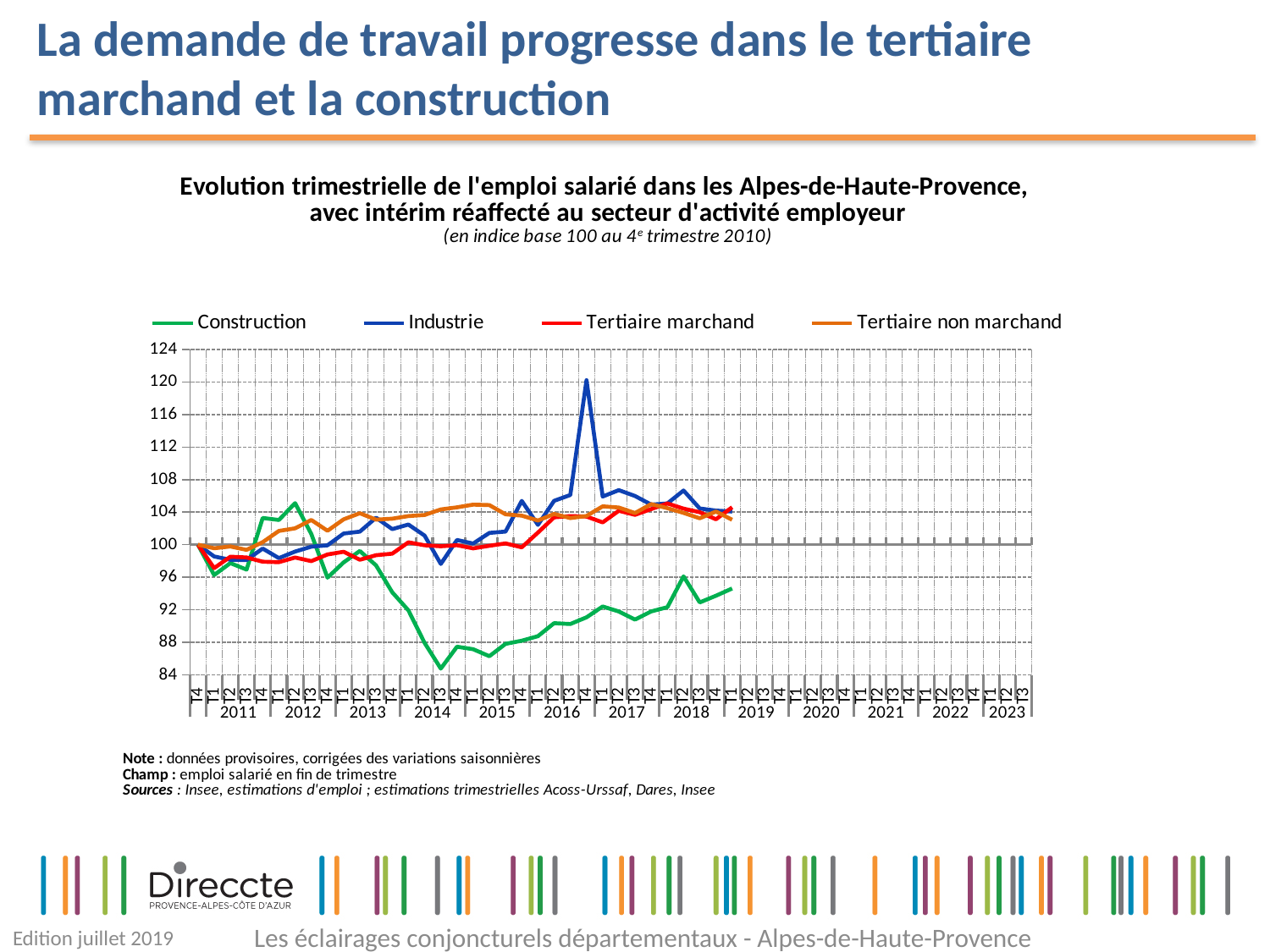
What kind of chart is shown on the slide? line chart Which series is shown in green in the legend? Construction Is the value for Tertiaire non marchand at T2 2015 greater or less than 100? greater How many series does the legend list? 4 Is the value for Construction at T1 2019 greater or less than 96? less Does the Tertiaire marchand series rise or fall between T1 2015 and T1 2018? rise Does the Construction series rise or fall between T2 2012 and T3 2014? fall Is the value for Industrie at T4 2016 greater or less than 116? greater Which series falls to the lowest value on the chart? Construction At T4 2016, which is larger: Industrie or Construction? Industrie Which series reaches the highest value on the chart? Industrie